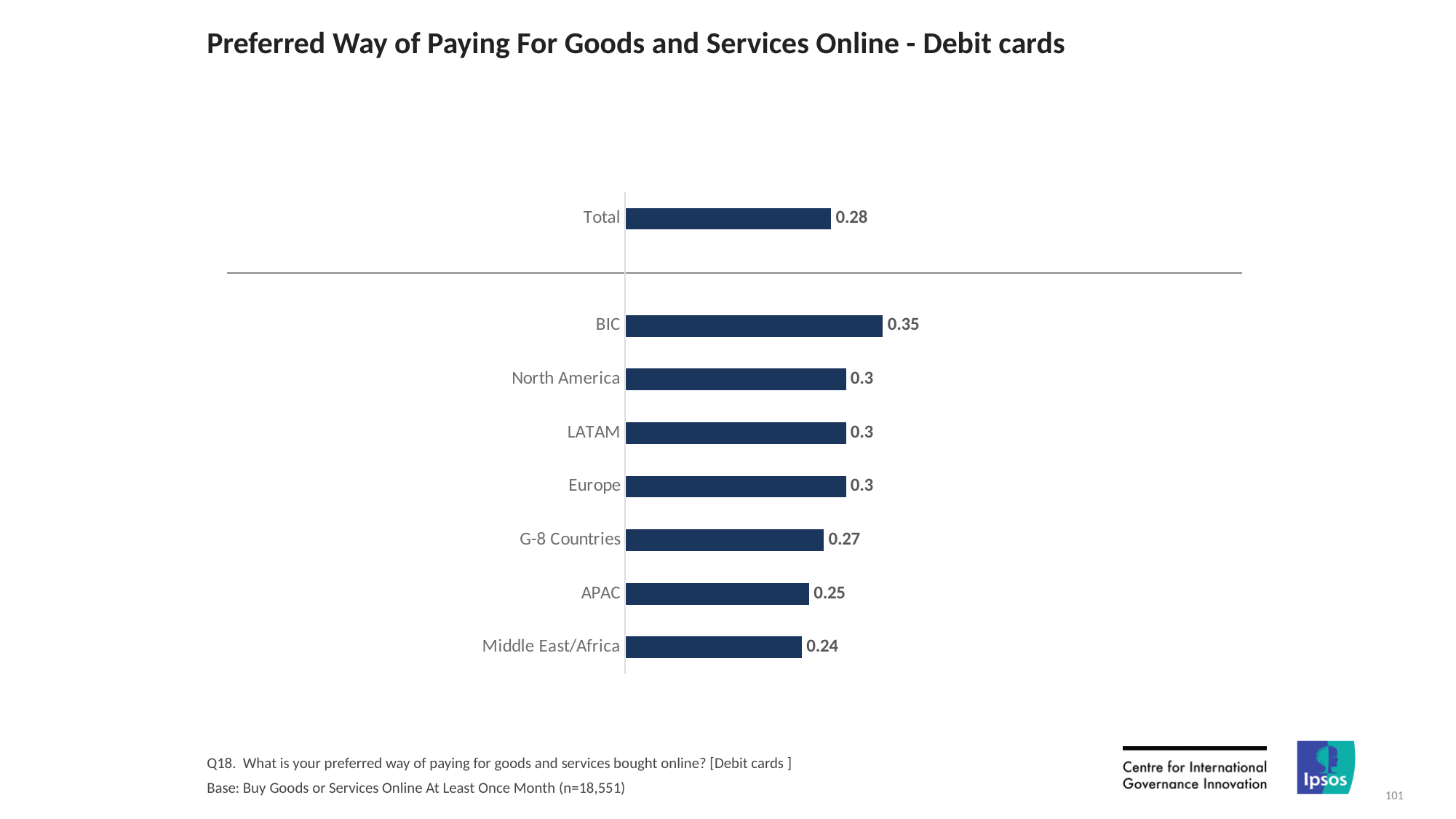
Which region has the lowest value? Middle East/Africa How many bars are shown in the chart, including Total? 8 What is the difference between the values for Total and Middle East/Africa? 0.04 What is the difference between the values for BIC and APAC? 0.1 What is the value for G-8 Countries? 0.27 Which region has the highest value? BIC What is the value for Total? 0.28 Which is larger, the value for G-8 Countries or the value for APAC? G-8 Countries What is the value for Middle East/Africa? 0.24 What is the value for BIC? 0.35 What kind of chart is shown on the slide? Bar chart What is the title of the chart? Preferred Way of Paying For Goods and Services Online - Debit cards